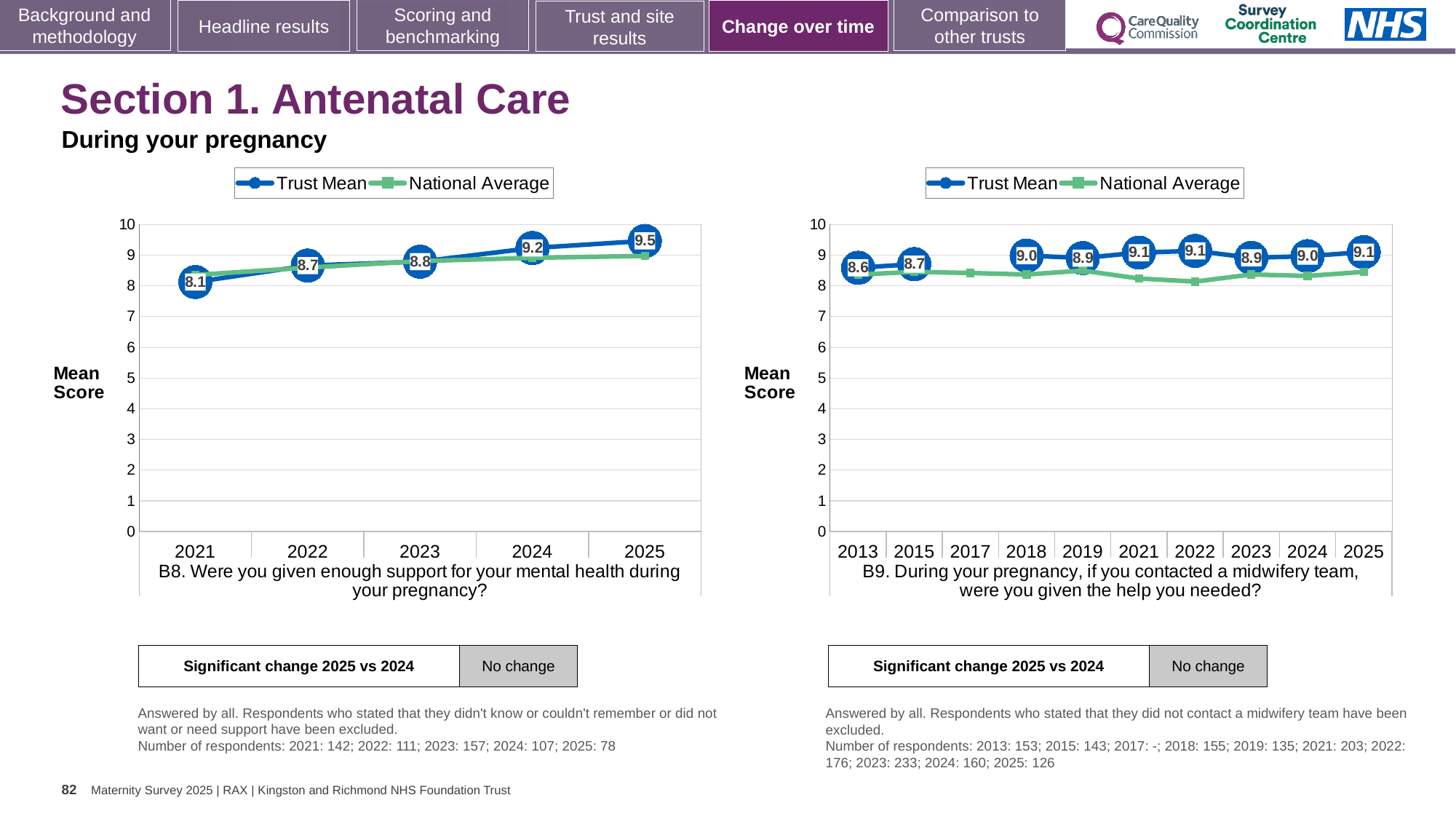
What type of chart is the B8 chart on the left? line chart In the B9 chart on the right, which year has the lowest Trust Mean? 2013 In the B8 chart on the left, what is the Trust Mean for 2021? 8.1 In the B9 chart on the right, how many years are shown on the x axis? 10 In the B8 chart on the left, what is the Trust Mean for 2025? 9.5 In the B9 chart on the right, what is the Trust Mean for 2024? 9.0 In the B8 chart on the left, does the Trust Mean rise or fall from 2021 to 2025? rise In the B8 chart on the left, is the National Average for 2021 greater or less than 8? greater In the B8 chart on the left, what is the difference between the Trust Mean in 2025 and in 2021? 1.4 In the B8 chart on the left, which year has the lowest Trust Mean? 2021 In the B9 chart on the right, what is the Trust Mean for 2013? 8.6 In the B9 chart on the right, is the Trust Mean higher in 2018 or in 2019? 2018